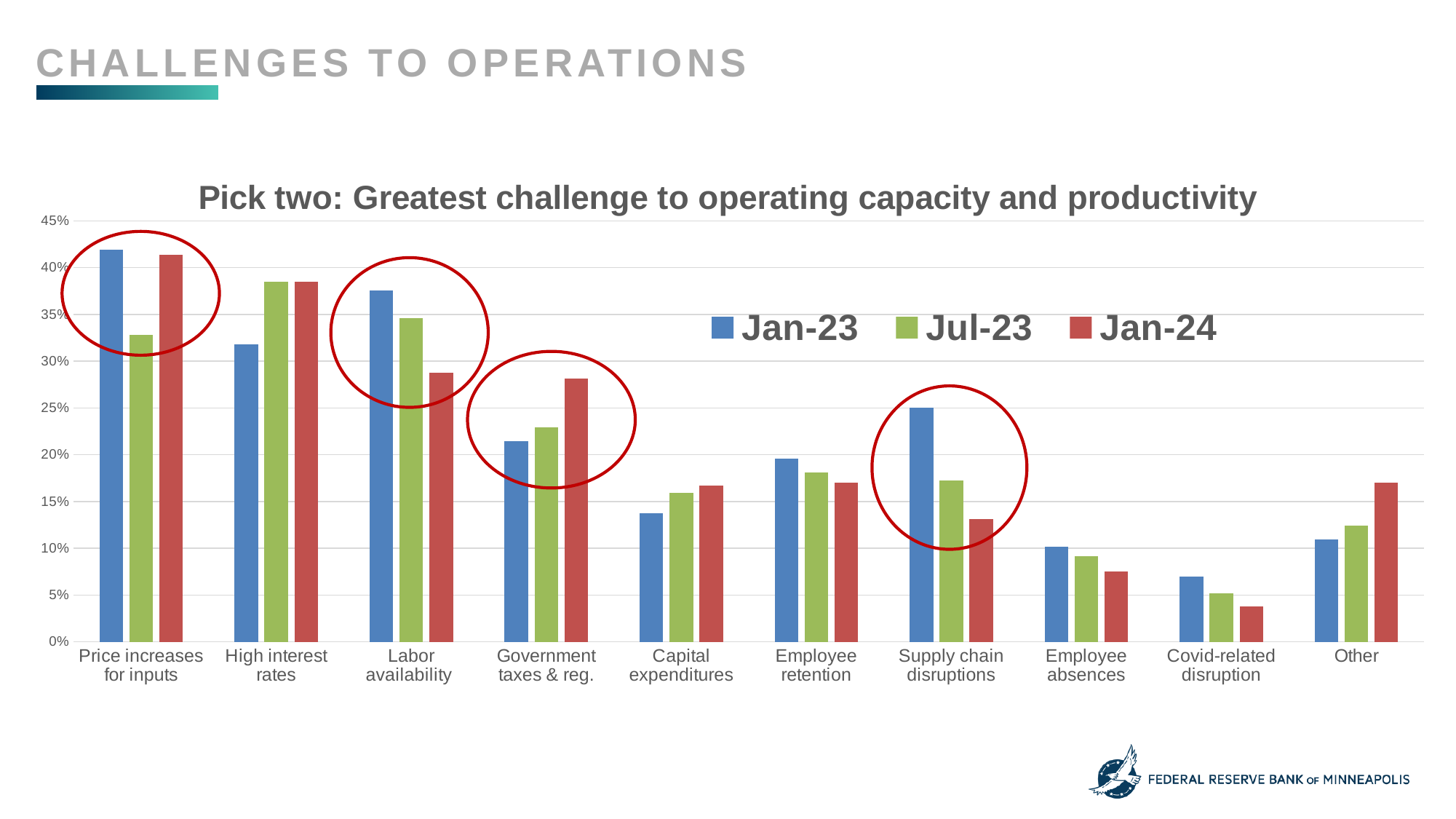
Do the values for Government taxes & reg. rise or fall from Jan-23 to Jul-23 to Jan-24? rise Which category has the lowest Jan-24 value? Covid-related disruption How many challenge categories are shown along the x axis? 10 Is the Jan-23 value for Employee retention greater or less than 15%? greater Which category has the highest Jan-23 value? Price increases for inputs For High interest rates, which is larger: the Jan-23 value or the Jul-23 value? Jul-23 Is the Jan-24 value for Government taxes & reg. greater or less than 25%? greater How many series does the legend list? 3 What are the three entries in the chart's legend? Jan-23, Jul-23, Jan-24 For Supply chain disruptions, which is larger: the Jan-23 value or the Jan-24 value? Jan-23 Is the Jul-23 value for Price increases for inputs greater or less than 35%? less What kind of chart is shown on the slide? Bar chart